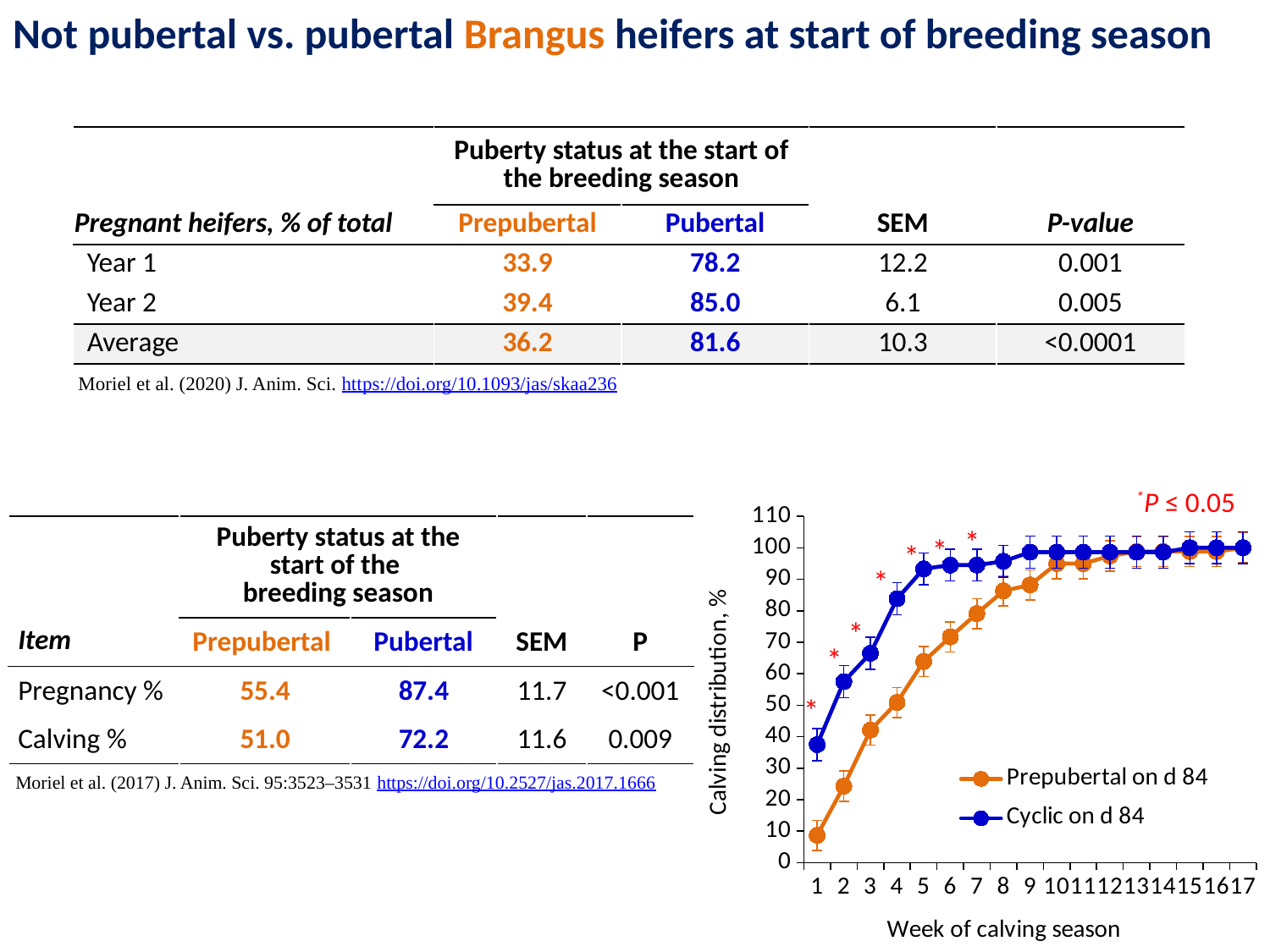
Is the value for Prepubertal on d 84 at week 8 greater or less than 80? greater Is the value for Prepubertal on d 84 at week 1 greater or less than 20? less Is the value for Cyclic on d 84 at week 1 greater or less than 30? greater How many weeks of the calving season are plotted on the x axis of the chart? 17 Do the values for Prepubertal on d 84 rise or fall as the week of calving season increases? rise What kind of chart is shown on the slide? line chart What is the y-axis title of the chart? Calving distribution, % At week 3, which series has the higher calving distribution, Prepubertal on d 84 or Cyclic on d 84? Cyclic on d 84 How many series does the chart legend list? 2 What are the two series named in the chart legend? Prepubertal on d 84 and Cyclic on d 84